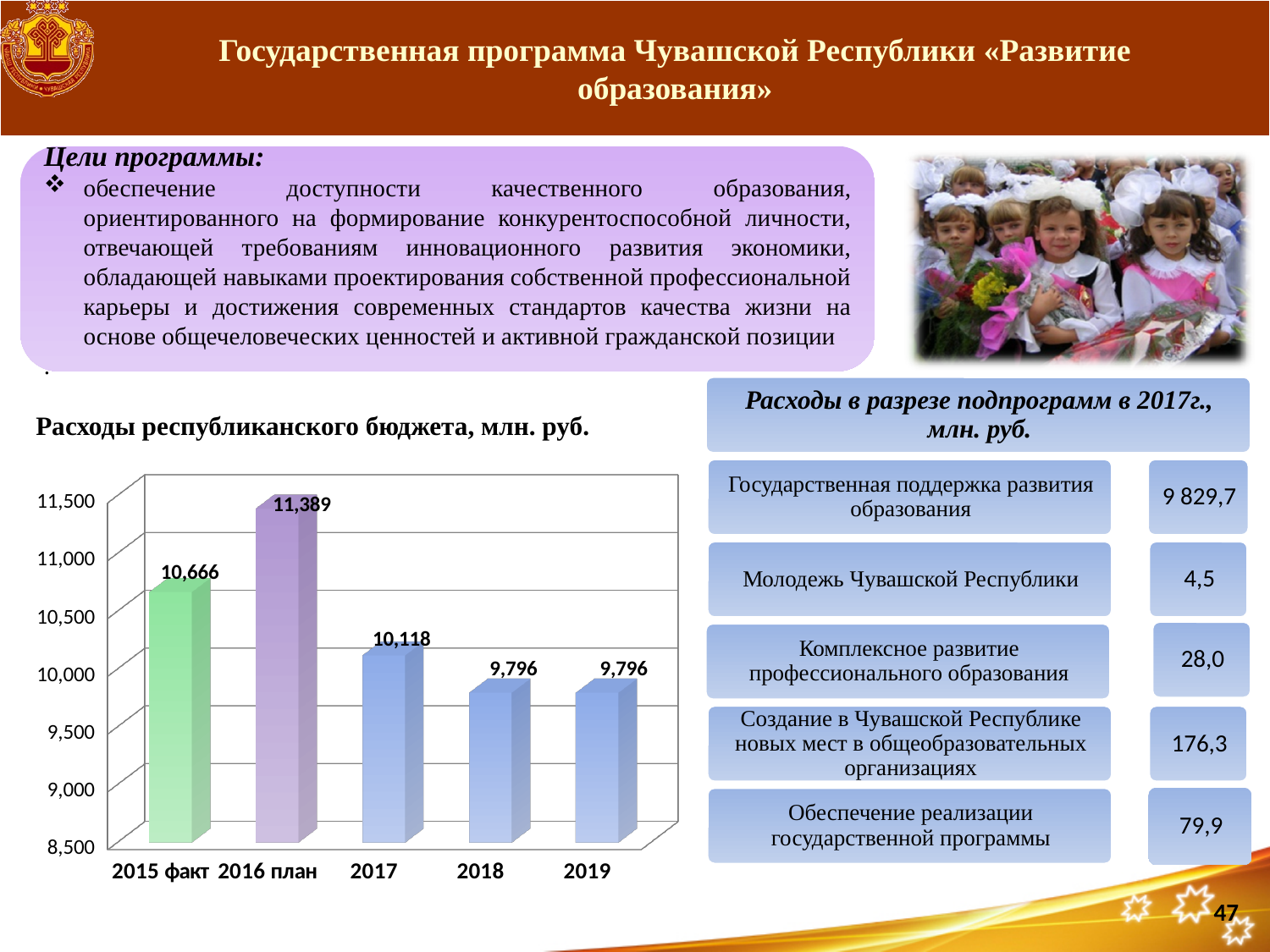
What is the value for 2019 in the chart 'Расходы республиканского бюджета, млн. руб.'? 9,796 What kind of chart is 'Расходы республиканского бюджета, млн. руб.'? bar chart What is the value for 2016 план in the chart 'Расходы республиканского бюджета, млн. руб.'? 11,389 In the chart 'Расходы республиканского бюджета, млн. руб.', which is larger: the value for 2015 факт or the value for 2017? 2015 факт What is the value for 2017 in the chart 'Расходы республиканского бюджета, млн. руб.'? 10,118 Which category has the highest value in the chart 'Расходы республиканского бюджета, млн. руб.'? 2016 план In the chart 'Расходы республиканского бюджета, млн. руб.', is the value for 2018 greater or less than 10,000? less What is the value for 2015 факт in the chart 'Расходы республиканского бюджета, млн. руб.'? 10,666 In the chart 'Расходы республиканского бюджета, млн. руб.', what is the difference between the values for 2016 план and 2015 факт? 723 How many bars are shown in the chart 'Расходы республиканского бюджета, млн. руб.'? 5 Which categories share the lowest value in the chart 'Расходы республиканского бюджета, млн. руб.'? 2018 and 2019 In the chart 'Расходы республиканского бюджета, млн. руб.', what is the difference between the values for 2017 and 2018? 322